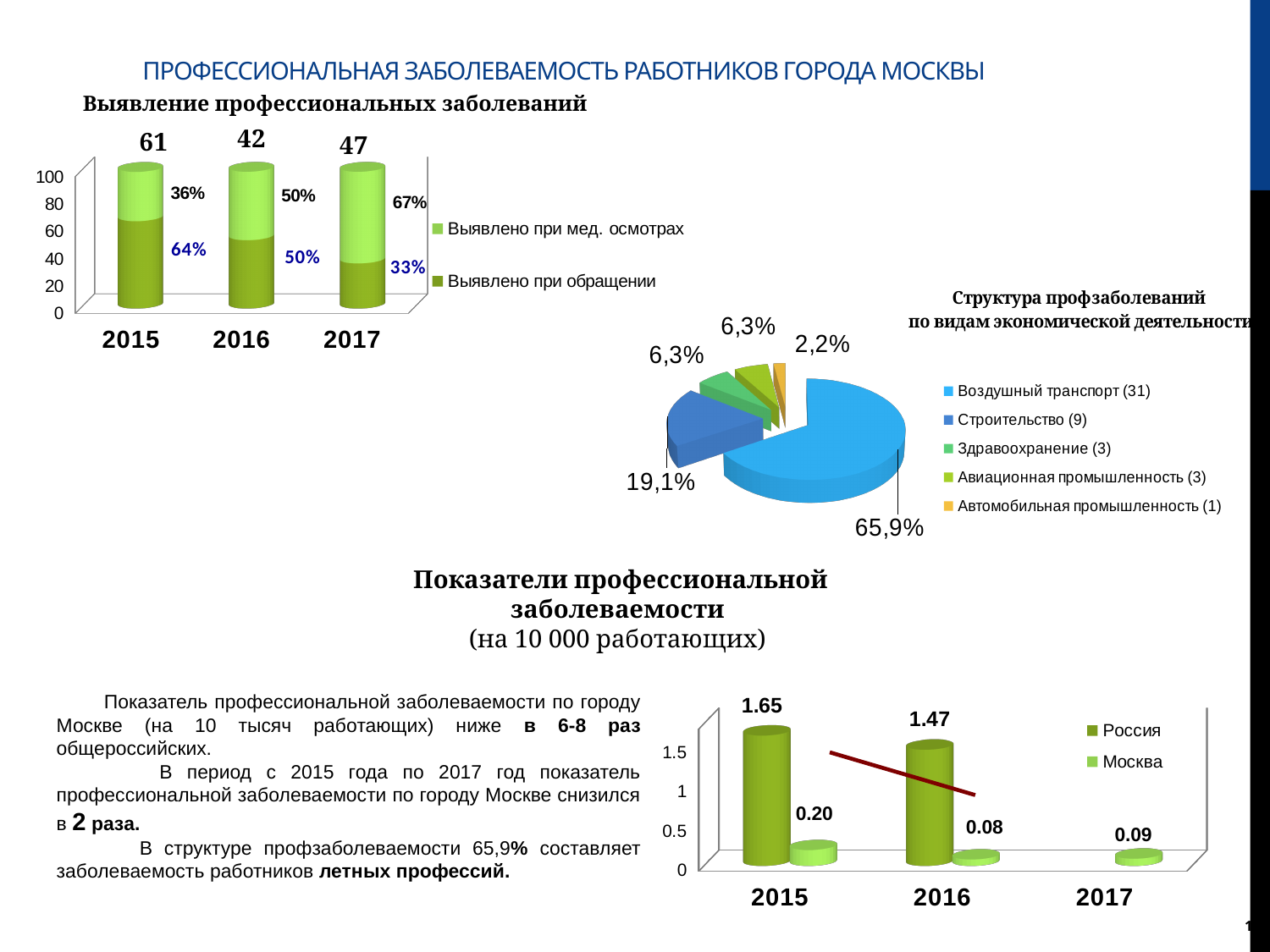
In the chart "Выявление профессиональных заболеваний", what percentage was detected при обращении in 2015? 64% In the chart "Показатели профессиональной заболеваемости", what is the difference between the Россия values for 2015 and 2016? 0.18 In the chart "Показатели профессиональной заболеваемости", what is the value for Россия in 2015? 1.65 In the pie chart "Структура профзаболеваний по видам экономической деятельности", which category has the largest slice? Воздушный транспорт (31) In the chart "Выявление профессиональных заболеваний", what percentage was detected at medical examinations (Выявлено при мед. осмотрах) in 2017? 67% In the chart "Выявление профессиональных заболеваний", what number is printed above the 2015 bar? 61 In the pie chart "Структура профзаболеваний по видам экономической деятельности", what share does Строительство have? 19,1% In the chart "Выявление профессиональных заболеваний", how many series does the legend list? 2 How many slices does the pie chart "Структура профзаболеваний по видам экономической деятельности" have? 5 In the chart "Выявление профессиональных заболеваний", does the share detected at medical examinations rise or fall from 2015 to 2017? rise What kind of chart is "Показатели профессиональной заболеваемости"? bar chart In the pie chart "Структура профзаболеваний по видам экономической деятельности", which category has the smallest slice? Автомобильная промышленность (1)